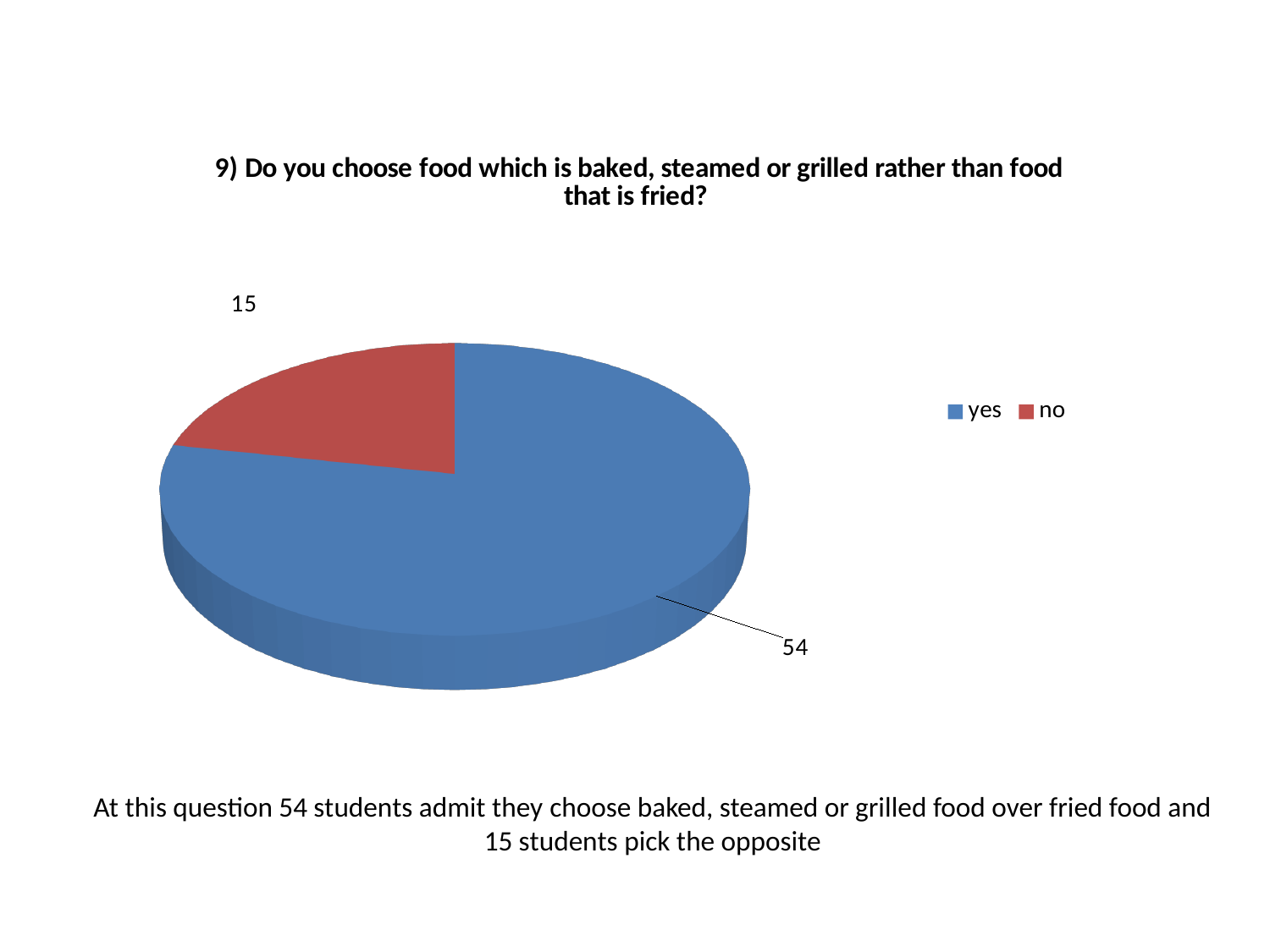
How many students answered "no" in the pie chart? 15 What colour is the "yes" slice in the pie chart? blue What colour is the "no" slice in the pie chart? red How many students answered "yes" in the pie chart? 54 Which is larger, the "yes" slice or the "no" slice? yes What kind of chart is shown on the slide? pie chart Which response has the smallest slice of the pie chart? no How many slices does the pie chart have? 2 How many entries does the legend list? 2 Which response has the largest slice of the pie chart? yes What is the total number of responses shown in the pie chart? 69 What is the difference between the number of "yes" and "no" responses? 39